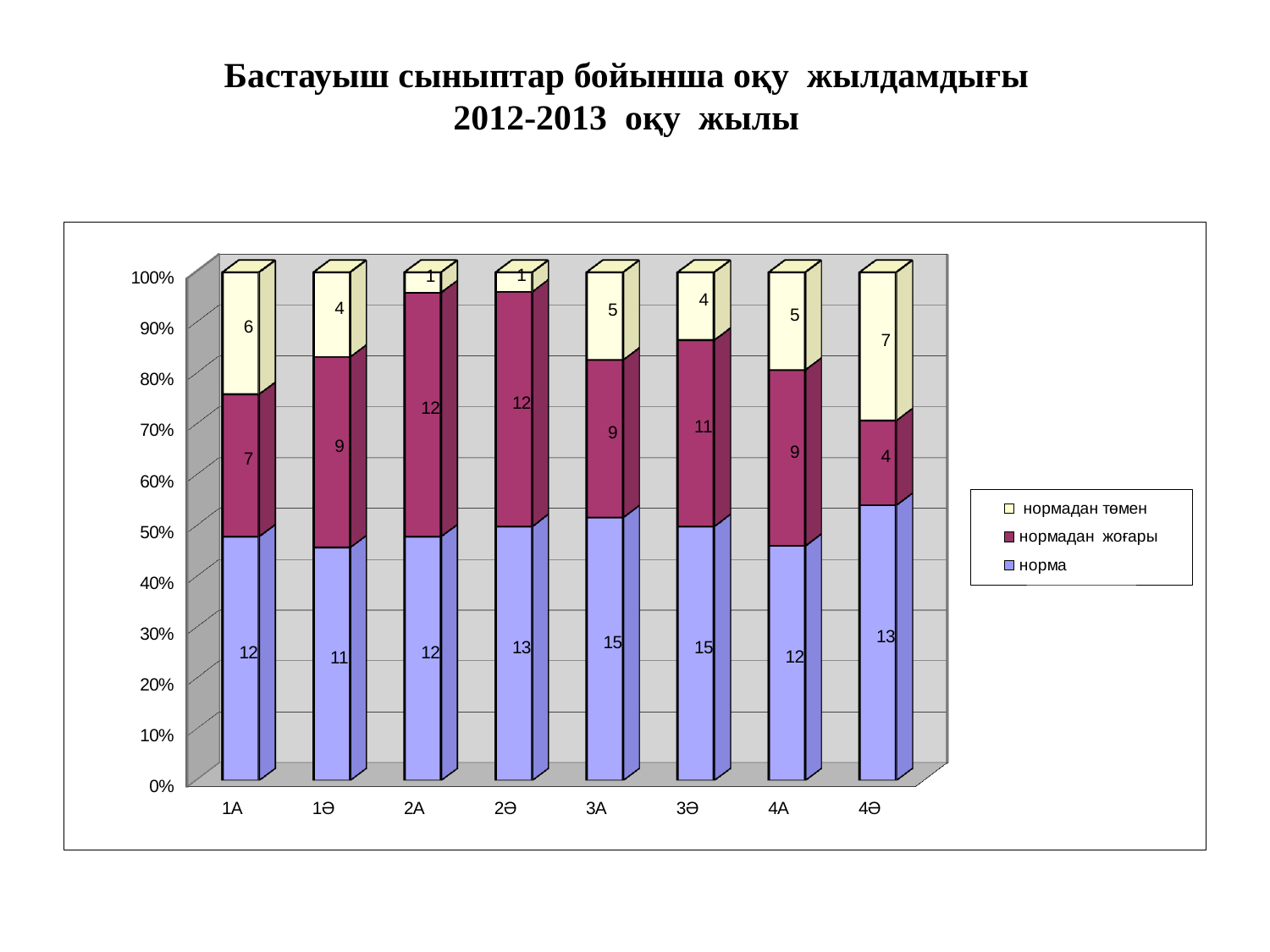
What is the value of норма for class 3А? 15 Which class has the lowest value for норма? 1Ә What is the value of нормадан төмен for class 1А? 6 Which class has the lowest value for нормадан жоғары? 4Ә How many classes are shown on the x axis? 8 What is the total of the three values in the bar for class 1А? 25 Which is larger, нормадан жоғары for 2А or нормадан жоғары for 4А? 2А What is the difference between the норма values for 2Ә and 1Ә? 2 What kind of chart is shown on the slide? Stacked bar chart Which class has the highest value for нормадан төмен? 4Ә How many series does the legend list? 3 What is the value of нормадан жоғары for class 3Ә? 11